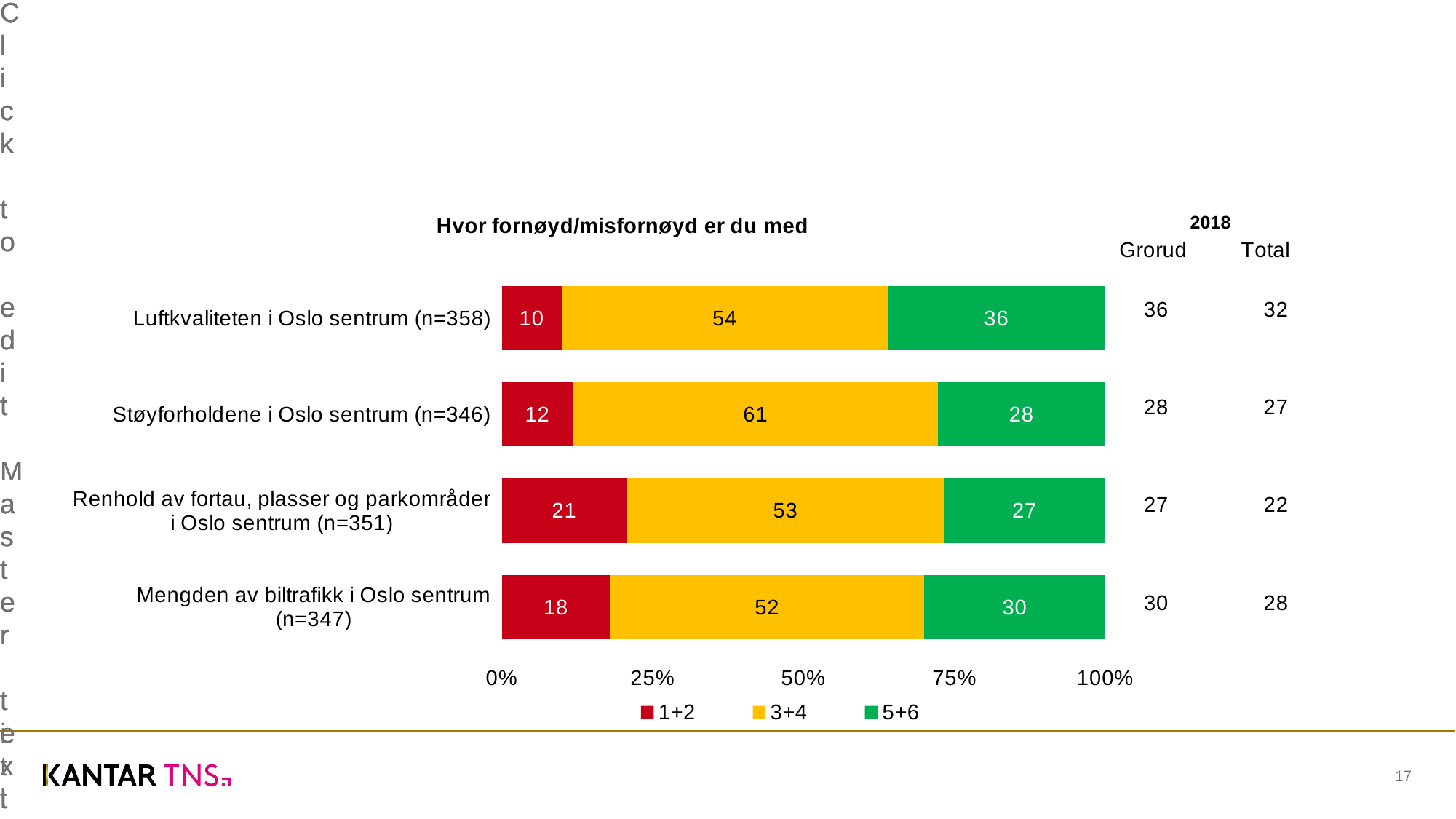
What is the total of the stacked bar for "Luftkvaliteten i Oslo sentrum (n=358)"? 100 What is the value of the 1+2 segment for "Renhold av fortau, plasser og parkområder i Oslo sentrum (n=351)"? 21 How many categories are plotted in the chart? 4 What is the title of the chart? Hvor fornøyd/misfornøyd er du med What kind of chart is shown on the slide? Stacked bar chart What is the difference between the 3+4 values for "Støyforholdene i Oslo sentrum (n=346)" and "Mengden av biltrafikk i Oslo sentrum (n=347)"? 9 Which is larger: the 5+6 value for "Mengden av biltrafikk i Oslo sentrum (n=347)" or for "Støyforholdene i Oslo sentrum (n=346)"? Mengden av biltrafikk i Oslo sentrum (n=347) What is the value of the 5+6 segment for "Luftkvaliteten i Oslo sentrum (n=358)"? 36 How many series does the legend list? 3 Which category has the lowest 5+6 value? Renhold av fortau, plasser og parkområder i Oslo sentrum (n=351) Which category has the highest 1+2 value? Renhold av fortau, plasser og parkområder i Oslo sentrum (n=351) What is the value of the 3+4 segment for "Støyforholdene i Oslo sentrum (n=346)"? 61